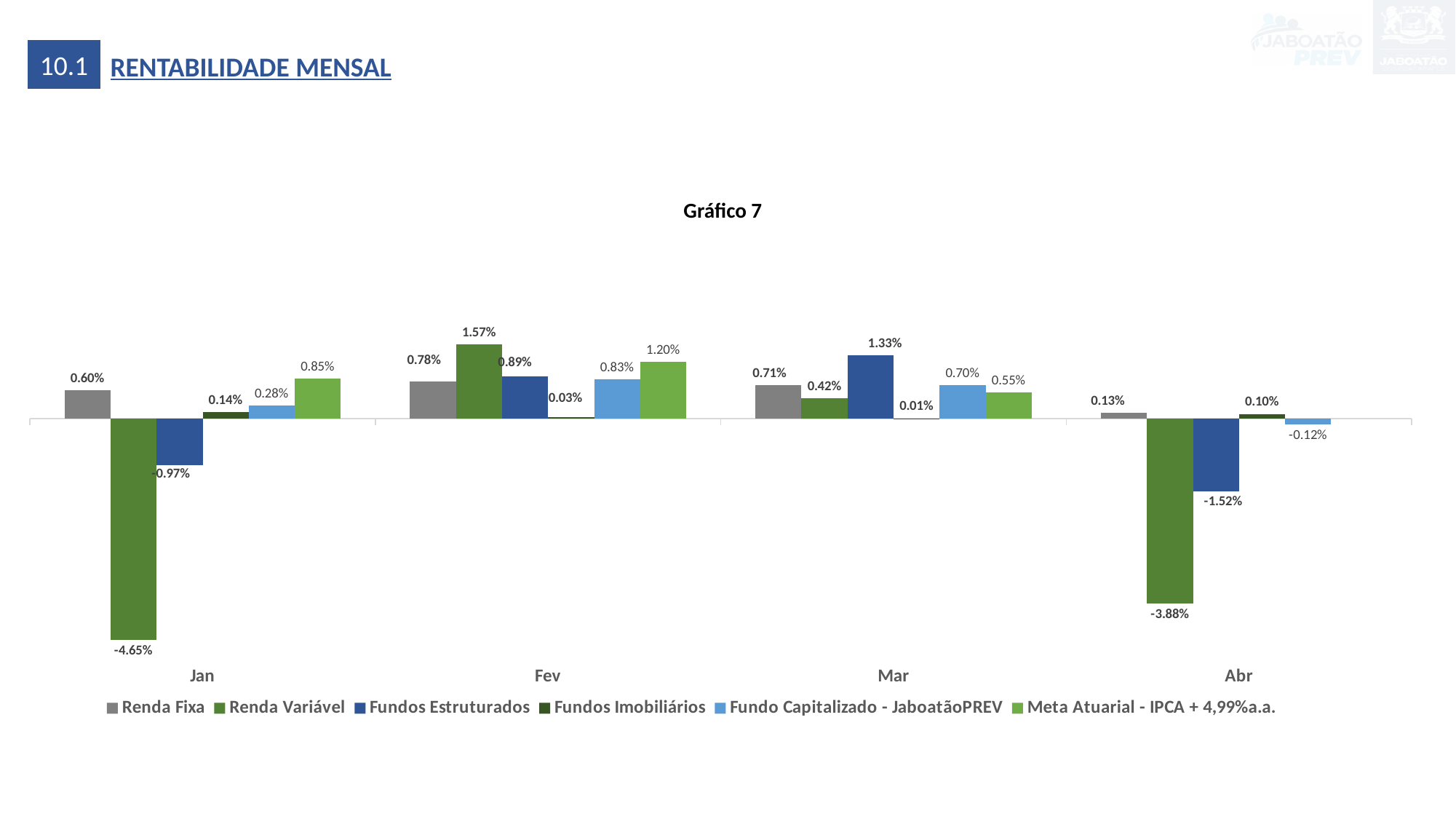
What is the value for Renda Variável in Jan? -4.65% Which is larger in Mar: Renda Fixa or Fundo Capitalizado - JaboatãoPREV? Renda Fixa In which month is the Renda Variável value lowest? Jan What kind of chart is shown? Bar chart What is the title of the chart? Gráfico 7 In which month is the Renda Fixa value highest? Fev How many series does the legend list? 6 What is the value for Meta Atuarial - IPCA + 4,99%a.a. in Fev? 1.20% What is the difference between the Renda Variável values in Fev and Abr? 5.45% What is the value for Fundo Capitalizado - JaboatãoPREV in Abr? -0.12% How many months are shown on the x axis? 4 What is the value for Fundos Estruturados in Mar? 1.33%